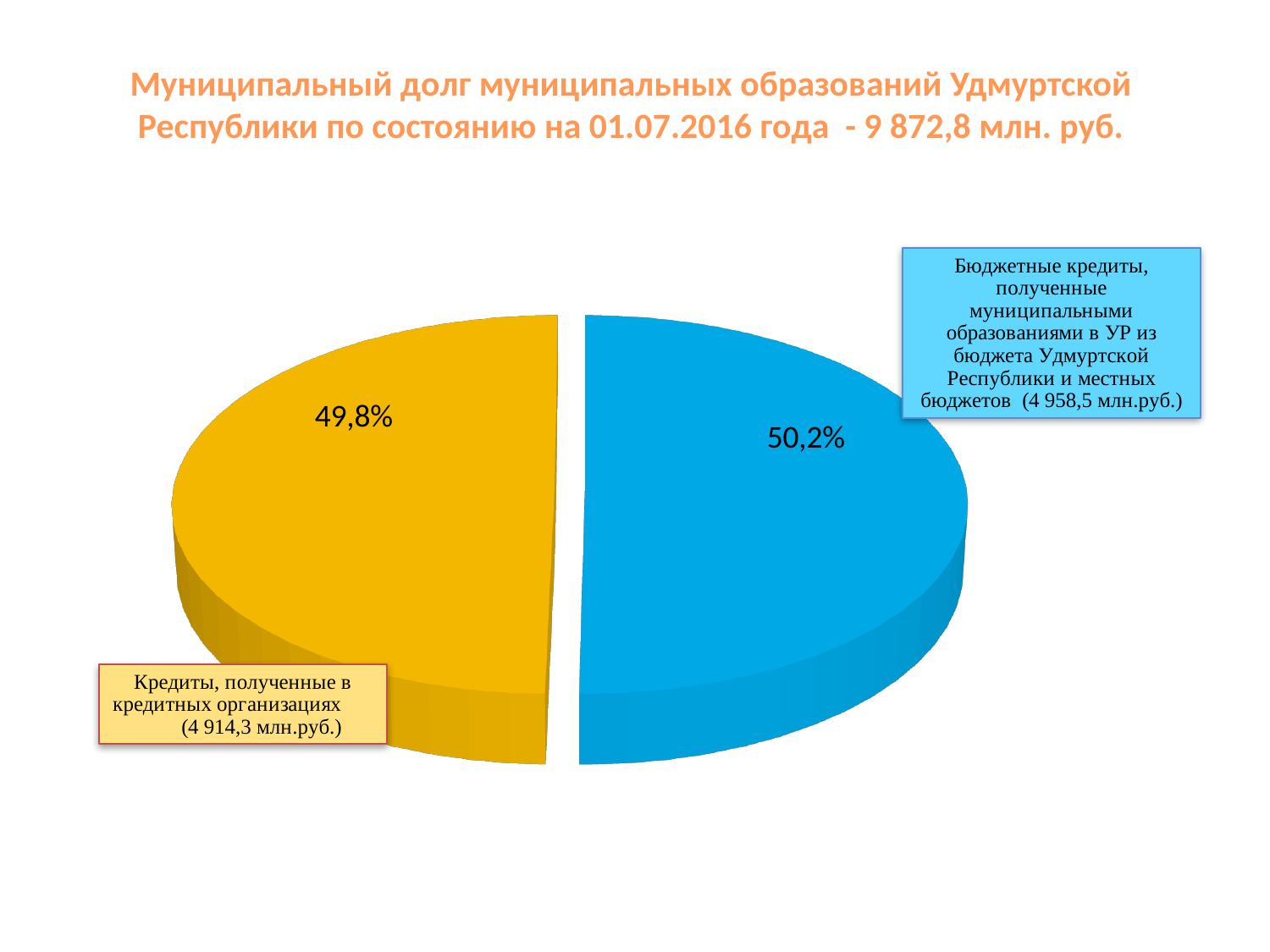
Which slice of the pie chart is the smallest? Кредиты, полученные в кредитных организациях Which slice of the pie chart is the largest? Бюджетные кредиты, полученные муниципальными образованиями в УР из бюджета Удмуртской Республики и местных бюджетов How many slices does the pie chart have? 2 What is the total municipal debt stated in the chart title as of 01.07.2016? 9 872,8 млн. руб. Which is larger: the share for "Бюджетные кредиты" or the share for "Кредиты, полученные в кредитных организациях"? Бюджетные кредиты What share of the pie is labelled for the slice "Бюджетные кредиты, полученные муниципальными образованиями в УР из бюджета Удмуртской Республики и местных бюджетов"? 50,2% What amount in млн.руб. is given for the slice "Кредиты, полученные в кредитных организациях"? 4 914,3 млн.руб. What amount in млн.руб. is given for the slice "Бюджетные кредиты" received from the budget of the Udmurt Republic and local budgets? 4 958,5 млн.руб. What kind of chart is shown on the slide? Pie chart What is the difference in percentage points between the two slices of the pie chart? 0,4 What colour is the slice representing "Кредиты, полученные в кредитных организациях"? Yellow What share of the pie is labelled for the slice "Кредиты, полученные в кредитных организациях"? 49,8%